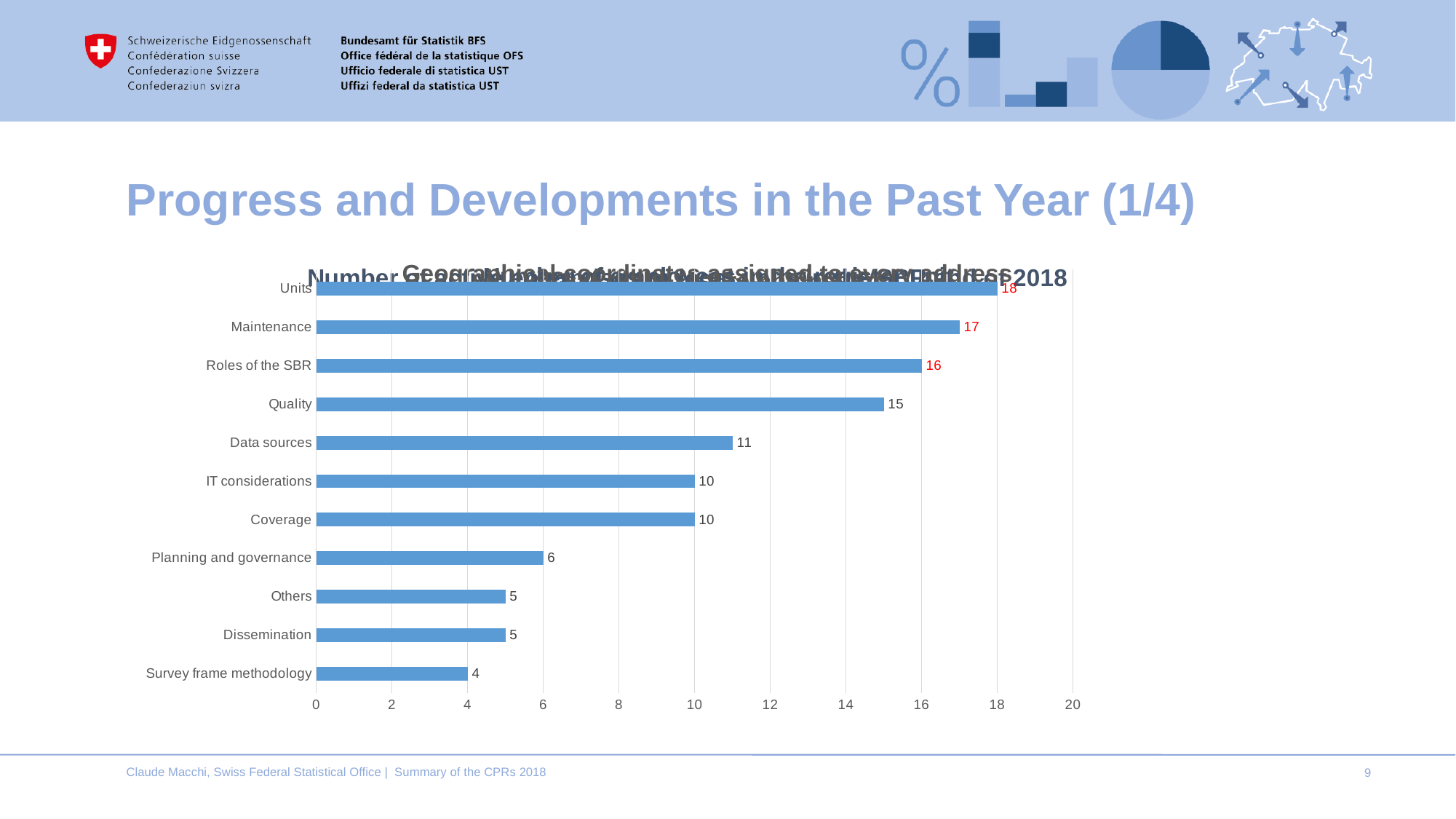
Which category has the lowest value? Survey frame methodology Which is larger, the value for Roles of the SBR or the value for Coverage? Roles of the SBR How many categories are shown in the chart? 11 Which category has the highest value? Units What is the value for Planning and governance? 6 What is the value for Quality? 15 What is the difference between the values for Maintenance and Data sources? 6 What is the value for IT considerations? 10 What is the value for Survey frame methodology? 4 Is the value for Data sources greater or less than 10? greater What is the value for Units? 18 What kind of chart is shown on the slide? Bar chart